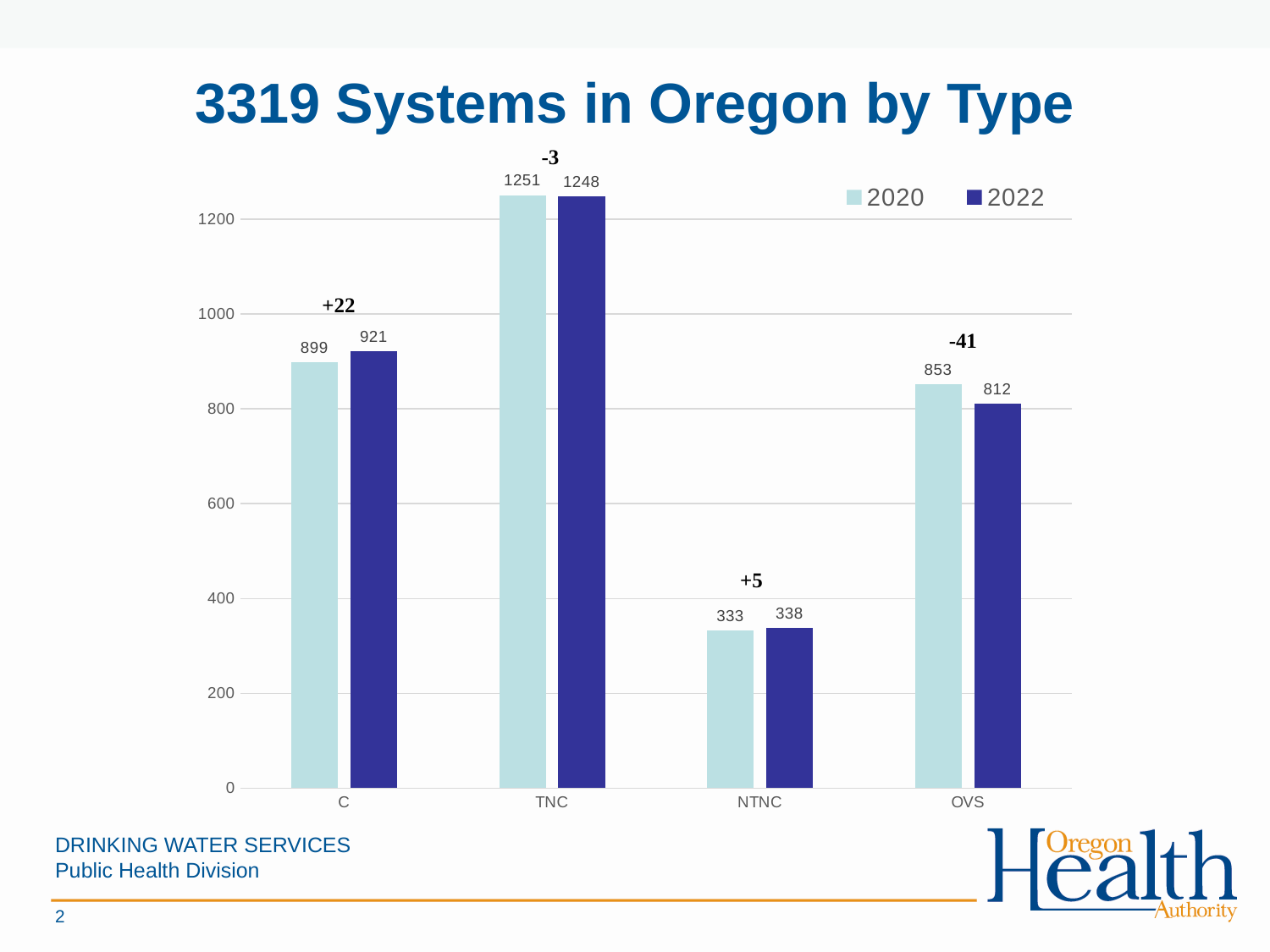
What is the difference between the 2022 and 2020 values for C? 22 What kind of chart is shown on the slide? Bar chart What is the 2020 value for TNC? 1251 Which is larger, the 2020 value for C or the 2020 value for OVS? 2020 value for C What is the title of the chart? 3319 Systems in Oregon by Type What is the 2022 value for OVS? 812 How many series does the legend list? 2 Which category has the lowest 2020 value? NTNC What is the 2020 value for NTNC? 333 Which category has the highest 2022 value? TNC How many categories are shown on the x axis? 4 What is the difference between the 2020 and 2022 values for OVS? 41